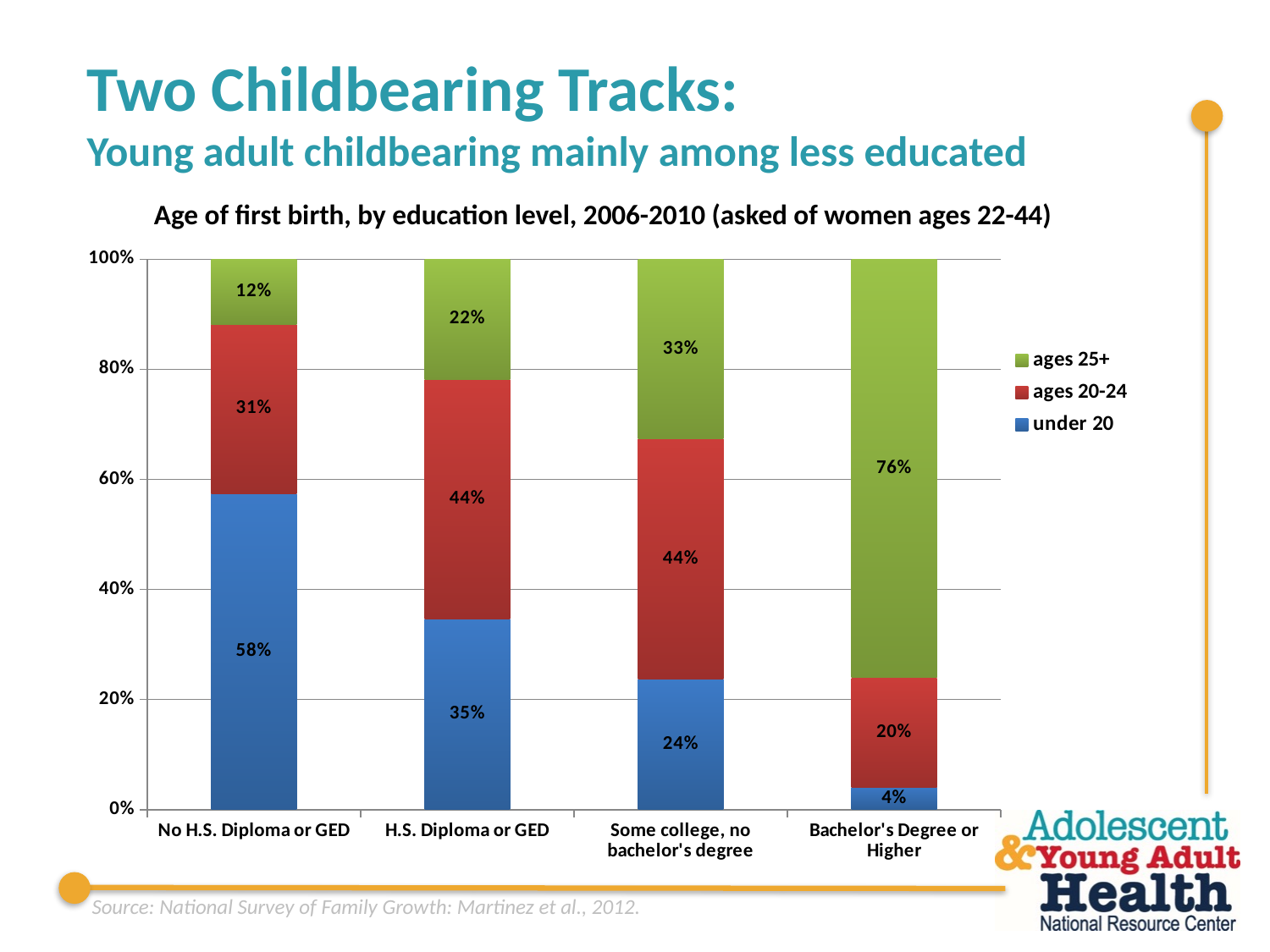
How many education level categories are shown on the x axis? 4 What percentage of women with no H.S. diploma or GED had their first birth under age 20? 58% How many series does the legend list? 3 Does the ages 25+ share rise or fall as education level increases from left to right? Rise What is the value for under 20 in the Some college, no bachelor's degree category? 24% Which education level has the lowest share of first births at ages 25+? No H.S. Diploma or GED What is the value for ages 20-24 in the H.S. Diploma or GED category? 44% What kind of chart is shown on the slide? Stacked bar chart What is the difference between the ages 25+ share for Bachelor's Degree or Higher and for Some college, no bachelor's degree? 43% What is the value for ages 25+ in the Bachelor's Degree or Higher category? 76% Which is larger: the under 20 share for H.S. Diploma or GED, or the under 20 share for Some college, no bachelor's degree? H.S. Diploma or GED Which education level has the highest share of first births under age 20? No H.S. Diploma or GED